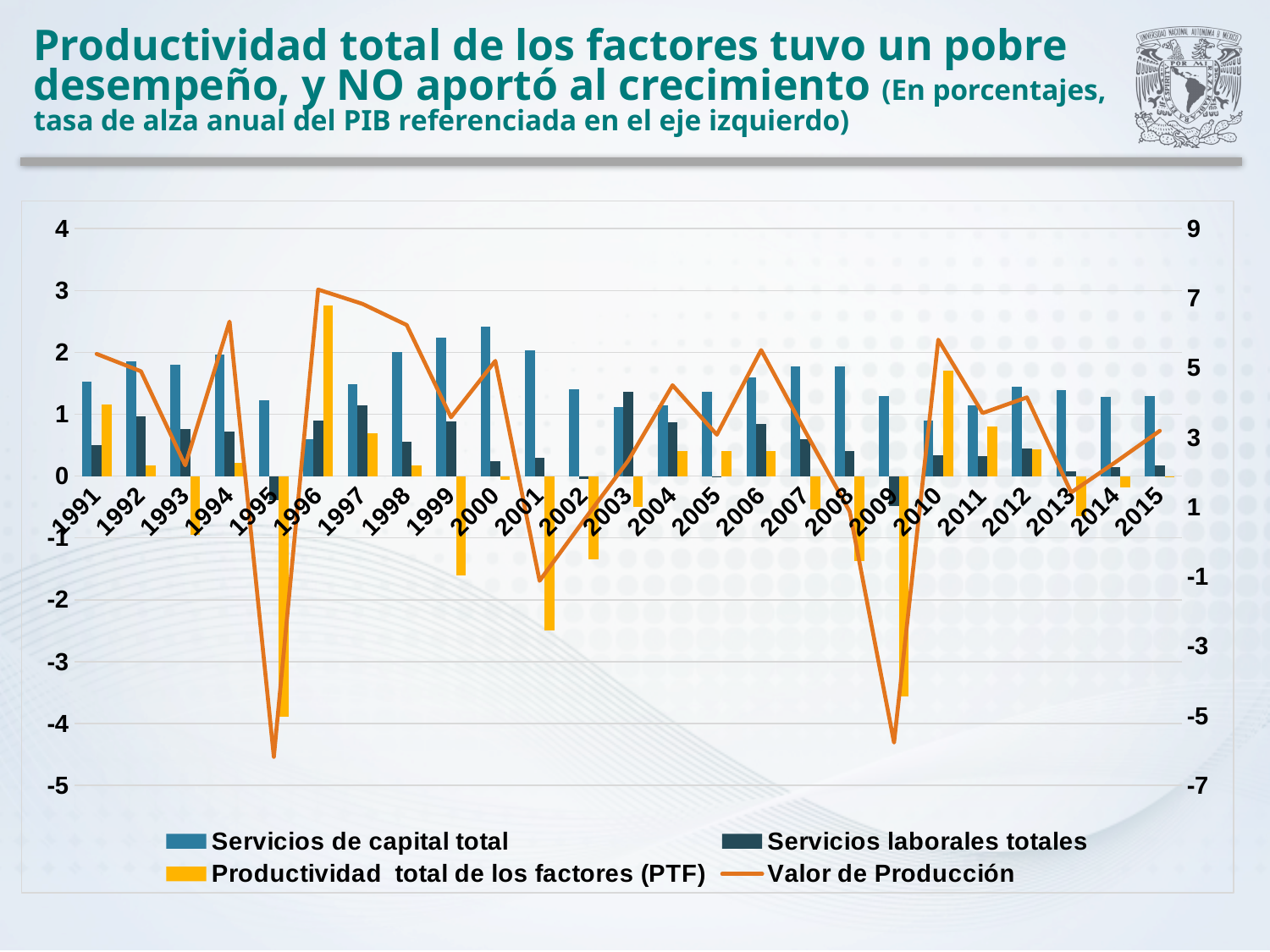
In which year is the Productividad total de los factores (PTF) bar lowest? 1995 Which series is drawn as a line rather than bars? Valor de Producción What kind of chart is shown on the slide? Combined bar and line chart In which year does the Valor de Producción line reach its highest point? 1996 Is the Productividad total de los factores (PTF) value for 1995 greater or less than -3? less In which year is the Productividad total de los factores (PTF) bar highest? 1996 Is the Servicios laborales totales value for 2009 greater or less than 0? less Which is larger, the Servicios de capital total value for 1999 or for 1995? 1999 How many series does the legend list? 4 How many years are shown on the x axis? 25 Does the Servicios de capital total series rise or fall from 2000 to 2003? fall Is the Servicios de capital total value for 2000 greater or less than 2? greater